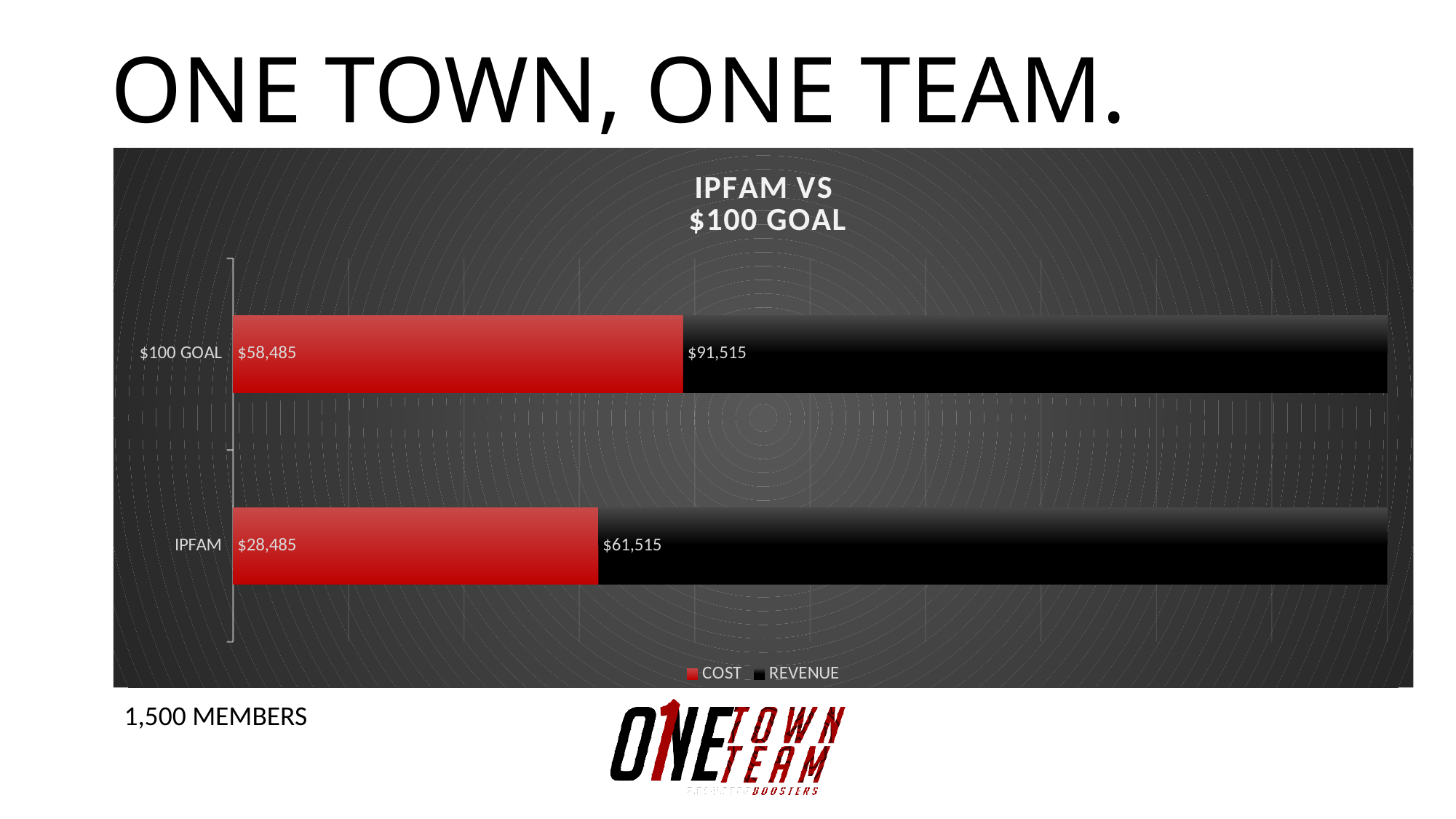
How many series does the legend list? 2 What is the REVENUE value for $100 GOAL? $91,515 What is the difference between the COST values for $100 GOAL and IPFAM? $30,000 What is the COST value for IPFAM? $28,485 Which category has the higher REVENUE value? $100 GOAL What type of chart is shown? Stacked bar chart Which category has the lower COST value? IPFAM Is the REVENUE value for IPFAM larger or smaller than the REVENUE value for $100 GOAL? smaller What is the total of the stacked bar for IPFAM? $90,000 What is the total of the stacked bar for $100 GOAL? $150,000 What is the REVENUE value for IPFAM? $61,515 What is the COST value for $100 GOAL? $58,485